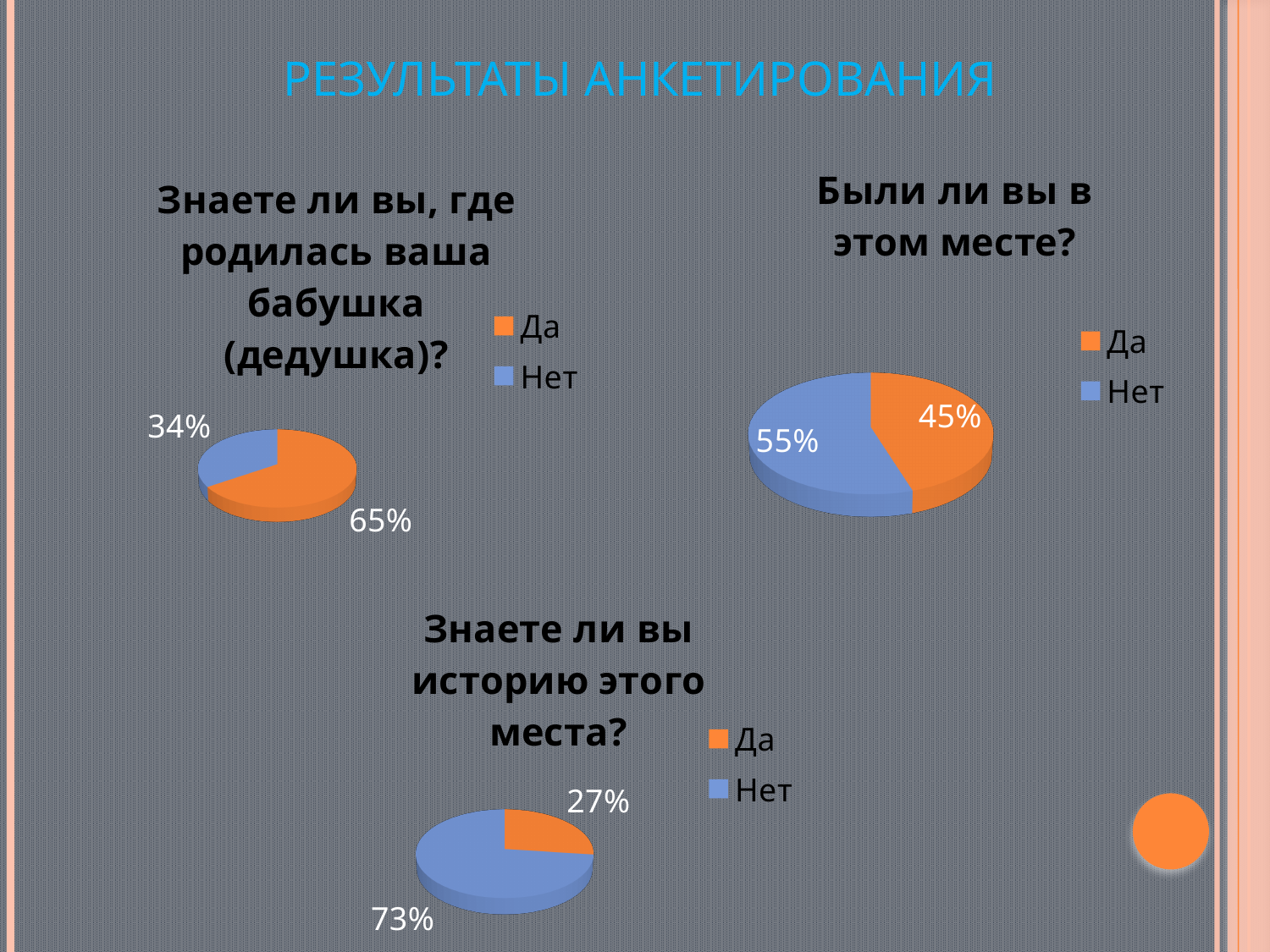
In the chart titled "Знаете ли вы историю этого места?", what share is labelled for "Да"? 27% In the chart titled "Были ли вы в этом месте?", what share is labelled for "Нет"? 55% In the chart titled "Знаете ли вы, где родилась ваша бабушка (дедушка)?", what share is labelled for "Нет"? 34% In the chart titled "Были ли вы в этом месте?", which slice is larger, "Да" or "Нет"? Нет How many pie charts are shown on the slide? 3 What type of chart is used for "Были ли вы в этом месте?"? Pie chart How many entries does the legend of the chart titled "Знаете ли вы историю этого места?" list? 2 In the chart titled "Знаете ли вы, где родилась ваша бабушка (дедушка)?", what share is labelled for "Да"? 65% In the chart titled "Были ли вы в этом месте?", what share is labelled for "Да"? 45% In the chart titled "Знаете ли вы, где родилась ваша бабушка (дедушка)?", what is the difference in percentage points between the "Да" and "Нет" slices? 31 In the chart titled "Знаете ли вы историю этого места?", which slice is the largest? Нет In the chart titled "Знаете ли вы историю этого места?", what share is labelled for "Нет"? 73%